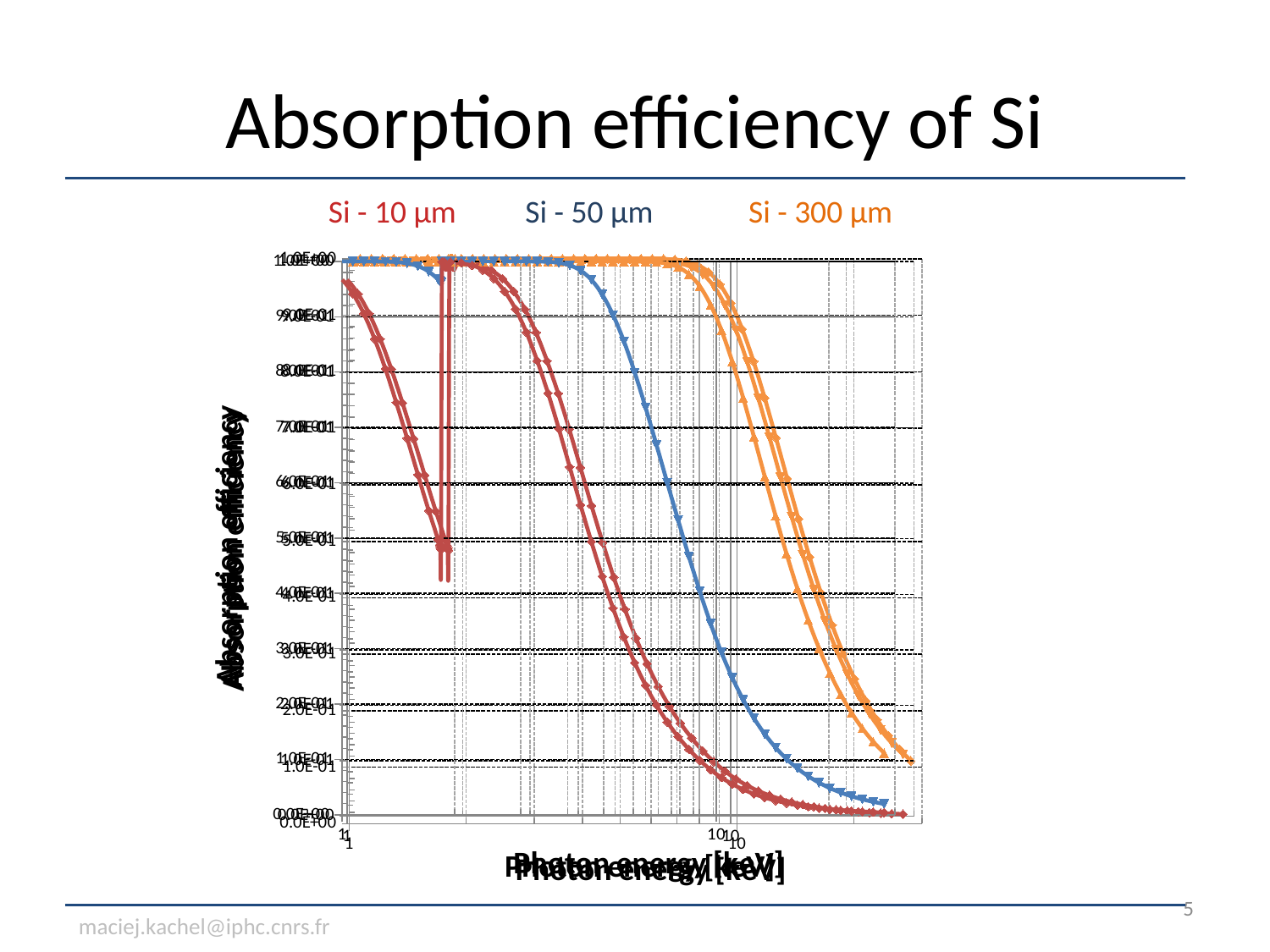
Do the absorption efficiency curves rise or fall as photon energy increases? fall At 10 keV, which series has the higher absorption efficiency, Si - 300 µm or Si - 10 µm? Si - 300 µm What is the label of the x axis? Photon energy [keV] Which series has the lowest absorption efficiency at 10 keV? Si - 10 µm Which series has the highest absorption efficiency at the right-hand end of the energy range? Si - 300 µm Is the absorption efficiency of Si - 50 µm at 2 keV greater or less than 0.8? greater Is the absorption efficiency of Si - 10 µm at 10 keV greater or less than 0.5? less Which colour represents the Si - 300 µm series? orange How many Si thickness series are labelled on the chart? 3 Which series drops below 0.5 absorption efficiency at the lowest photon energy? Si - 10 µm Is the absorption efficiency of Si - 300 µm at 10 keV greater or less than 0.8? greater What kind of chart is shown on the slide? line chart